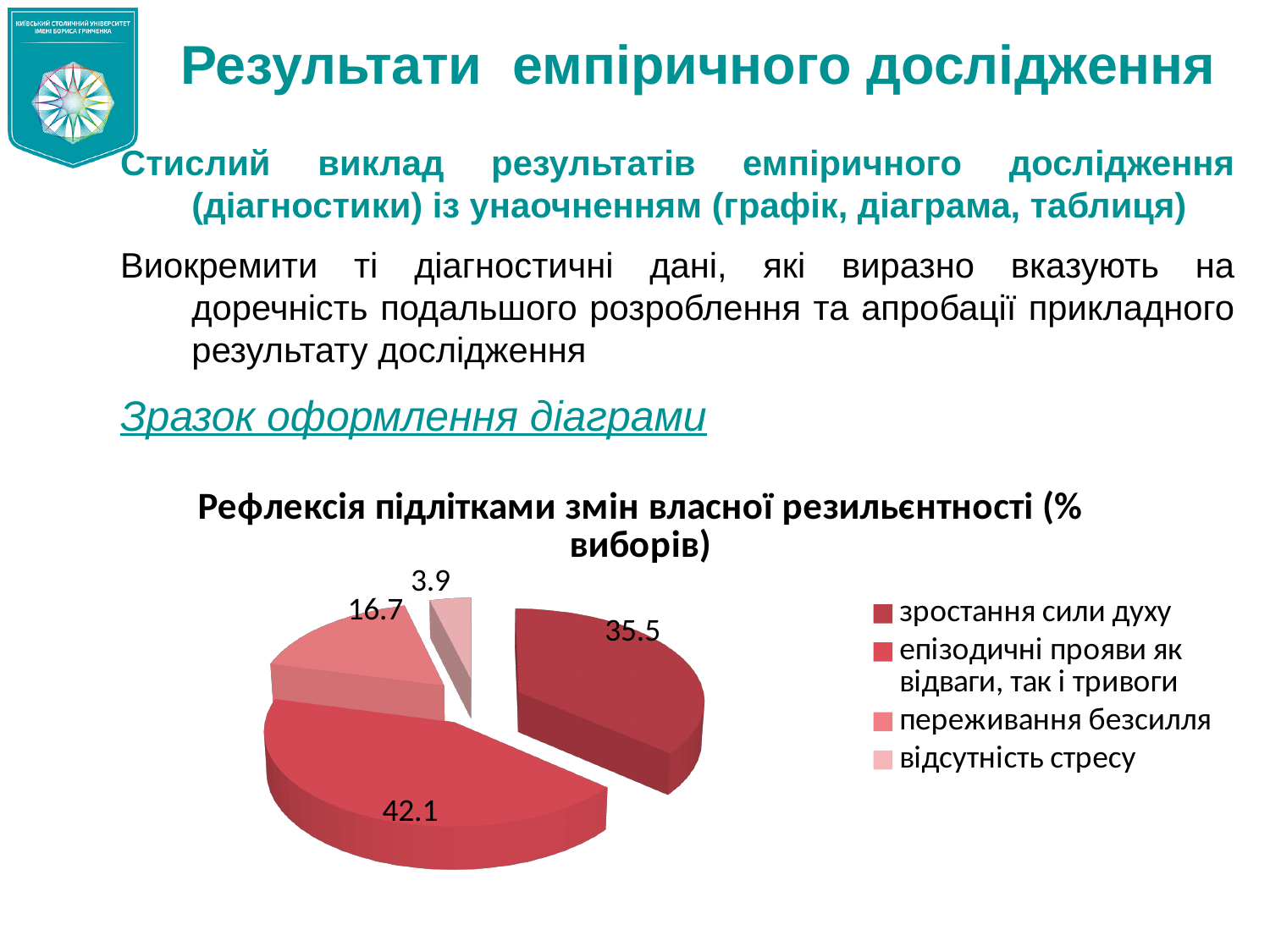
Which category has the largest slice of the pie? епізодичні прояви як відваги, так і тривоги What is the title of the chart? Рефлексія підлітками змін власної резильєнтності (% виборів) How many entries does the legend list? 4 Which category has the smallest slice of the pie? відсутність стресу How many slices does the pie chart have? 4 What is the value for "відсутність стресу"? 3.9 What is the value for "зростання сили духу"? 35.5 What is the difference between the values for "епізодичні прояви як відваги, так і тривоги" and "зростання сили духу"? 6.6 What is the value for "переживання безсилля"? 16.7 Which is larger: the value for "переживання безсилля" or the value for "відсутність стресу"? переживання безсилля What kind of chart is shown on the slide? pie chart What is the value for "епізодичні прояви як відваги, так і тривоги"? 42.1